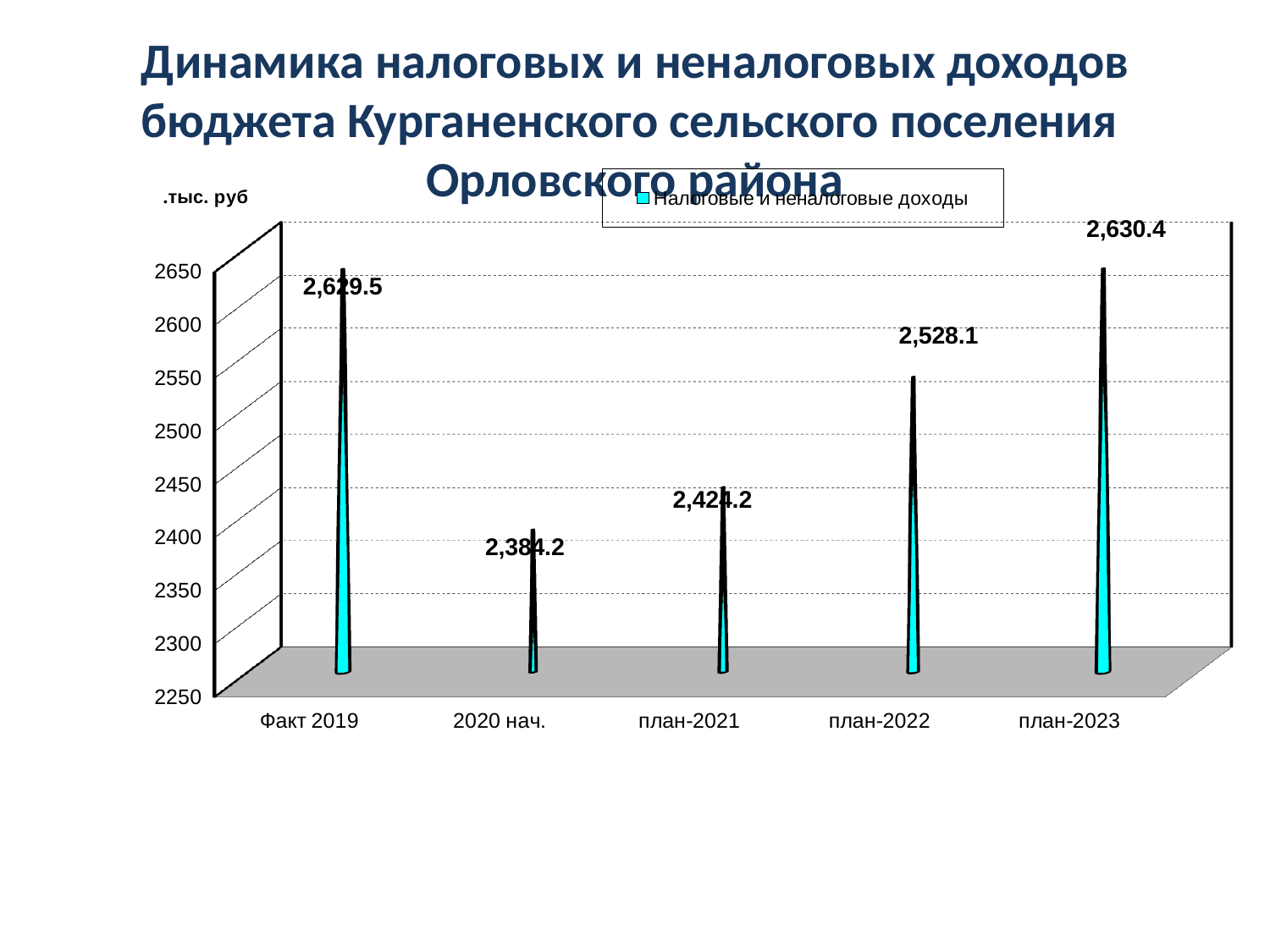
What is the difference between the values for план-2022 and план-2021? 103.9 Which category has the lowest value? 2020 нач. What is the value for 2020 нач.? 2,384.2 From 2020 нач. to план-2023, do the values rise or fall? rise Which is larger, the value for план-2021 or the value for план-2022? план-2022 What is the value for план-2023? 2,630.4 What kind of chart is shown on the slide? bar chart What is the difference between the values for план-2023 and 2020 нач.? 246.2 What is the value for Факт 2019? 2,629.5 What is the value for план-2022? 2,528.1 Is the value for план-2022 greater or less than 2500? greater How many categories are shown on the x axis? 5